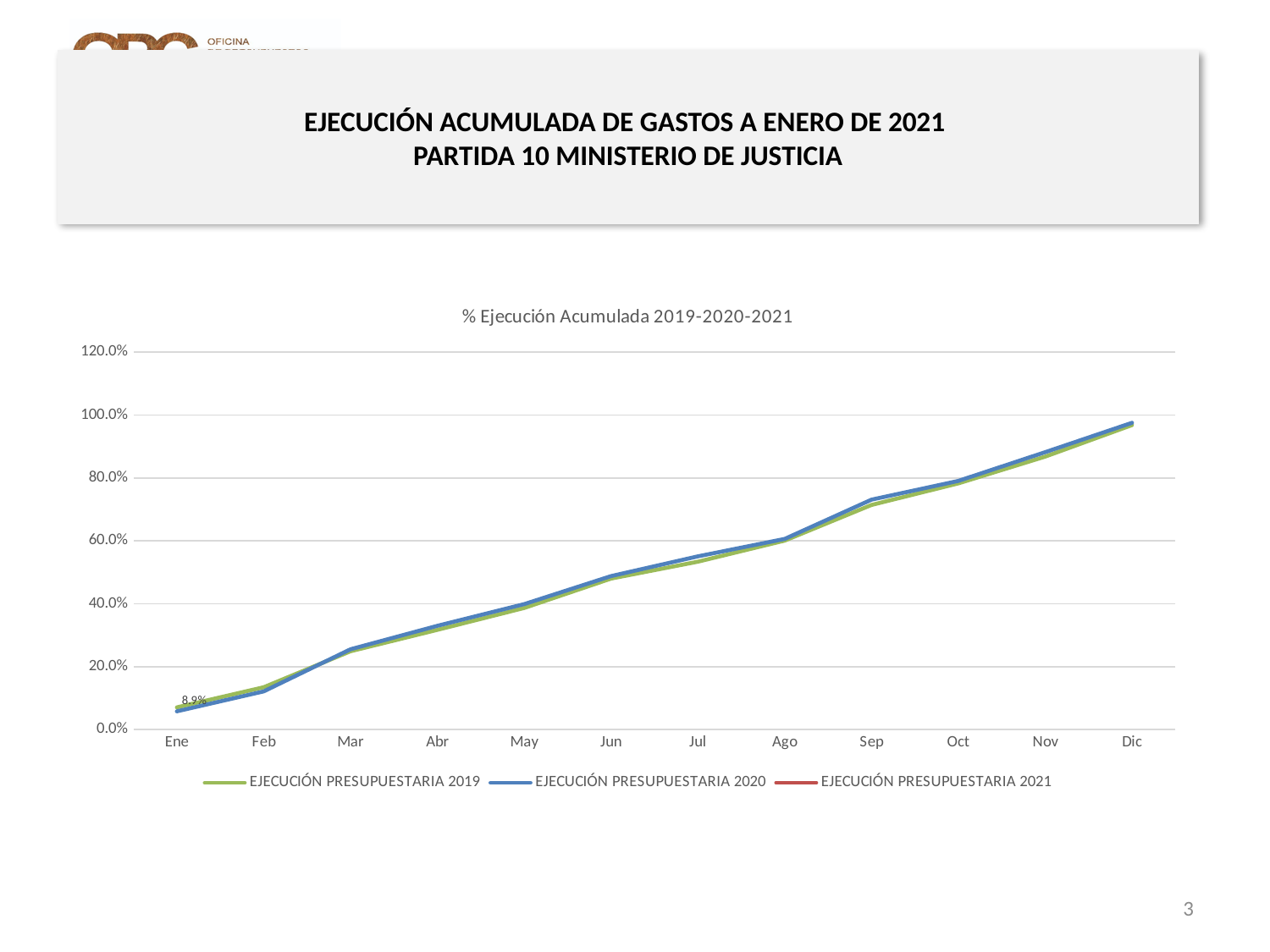
Is the value for EJECUCIÓN PRESUPUESTARIA 2019 in Feb greater or less than 20.0%? less What kind of chart is shown on the slide? line chart How many series does the legend list? 3 What value is printed as a data label near Ene? 8.9% Do the values for EJECUCIÓN PRESUPUESTARIA 2020 rise or fall from Ene to Dic? rise What is the highest value shown on the y axis? 120.0% Is the value for EJECUCIÓN PRESUPUESTARIA 2020 in Sep greater or less than 60.0%? greater Is the value for EJECUCIÓN PRESUPUESTARIA 2020 in Dic greater or less than 80.0%? greater How many months are shown along the x axis? 12 What is the title of the chart? % Ejecución Acumulada 2019-2020-2021